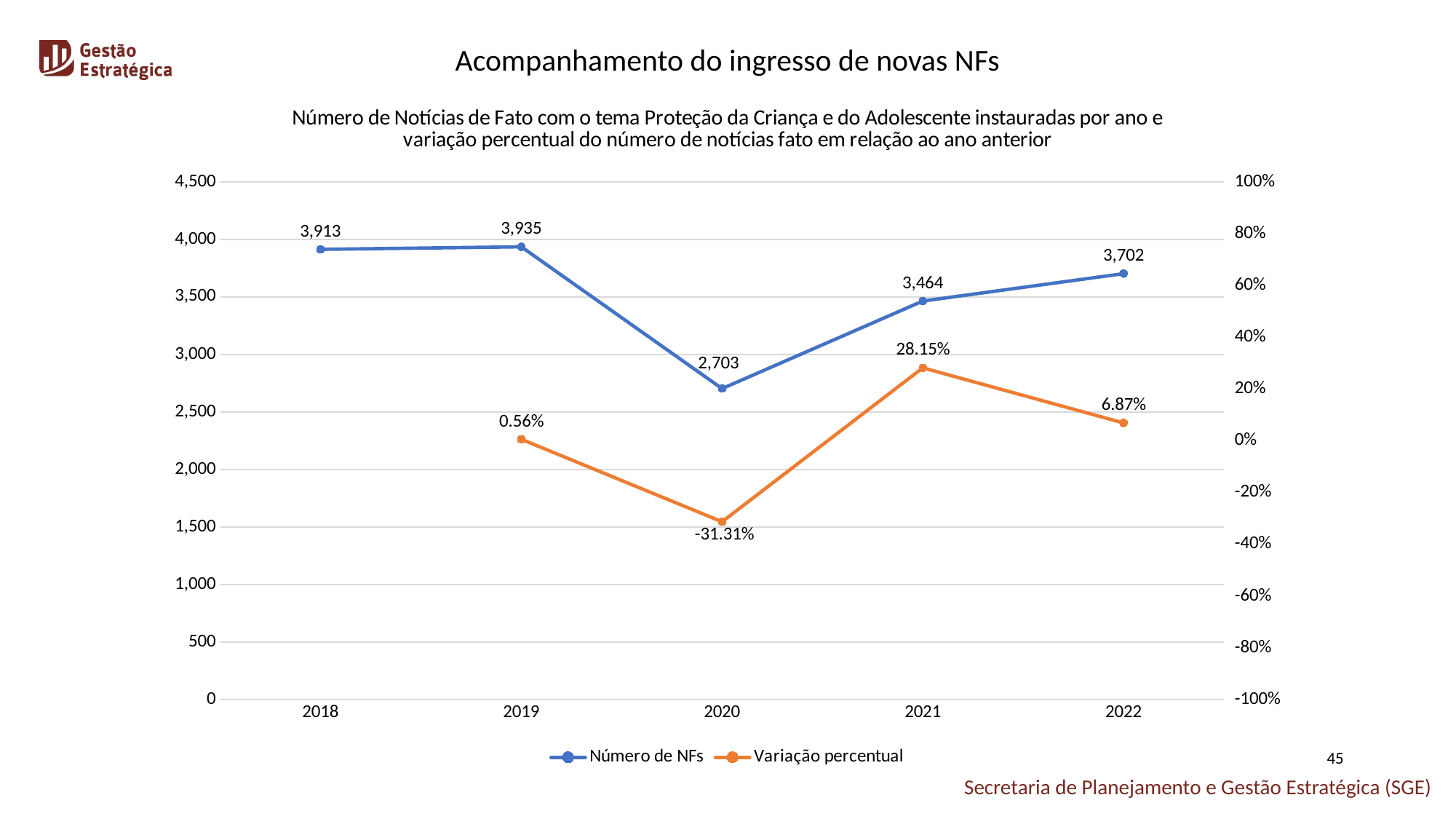
Which year has the lowest Variação percentual? 2020 What kind of chart is shown on the slide? line chart Is the Número de NFs for 2018 greater or less than 3,500? greater How many series does the legend list? 2 Which year has the highest Número de NFs? 2019 Is the Número de NFs larger in 2021 or in 2022? 2022 Does the Número de NFs rise or fall from 2020 to 2022? rise What is the difference in Número de NFs between 2019 and 2020? 1,232 How many years are shown on the x axis? 5 What colour is the line for Variação percentual? orange What is the Variação percentual for 2021? 28.15% What is the value of Número de NFs for 2020? 2,703